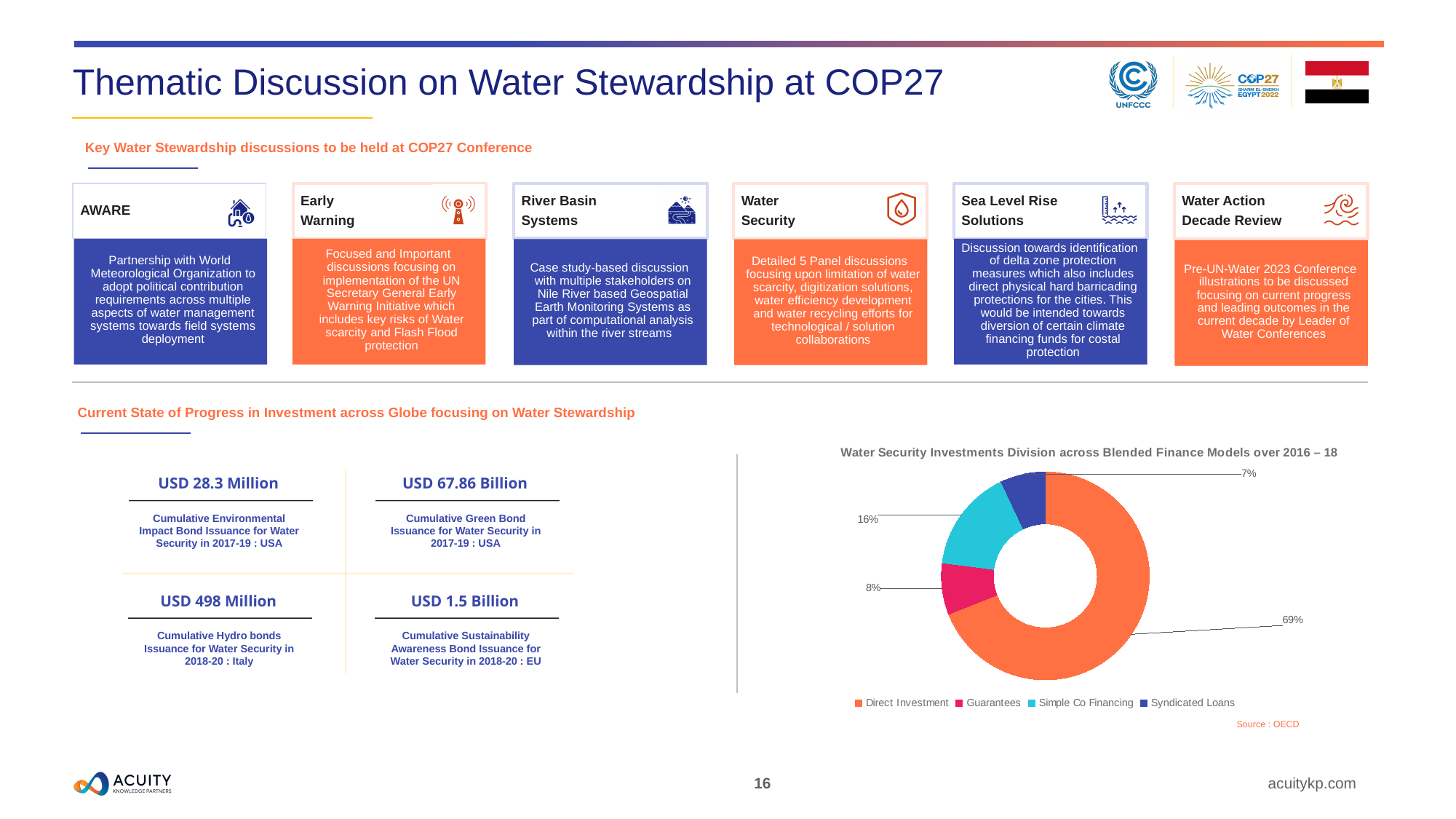
In the pie chart, what is the difference in percentage points between Direct Investment and Simple Co Financing? 53 percentage points What share of water security investments is Simple Co Financing in the pie chart? 16% Which blended finance model has the smallest share in the pie chart? Syndicated Loans How many categories does the pie chart's legend list? 4 What is the source cited for the pie chart? OECD What share of water security investments is Direct Investment in the pie chart? 69% What share of water security investments is Syndicated Loans in the pie chart? 7% Which blended finance model has the largest share in the pie chart? Direct Investment In the pie chart, which is larger: Simple Co Financing or Guarantees? Simple Co Financing What share of water security investments is Guarantees in the pie chart? 8% What kind of chart is shown under 'Water Security Investments Division across Blended Finance Models over 2016 – 18'? Pie chart (donut) What colour represents Direct Investment in the pie chart? Orange